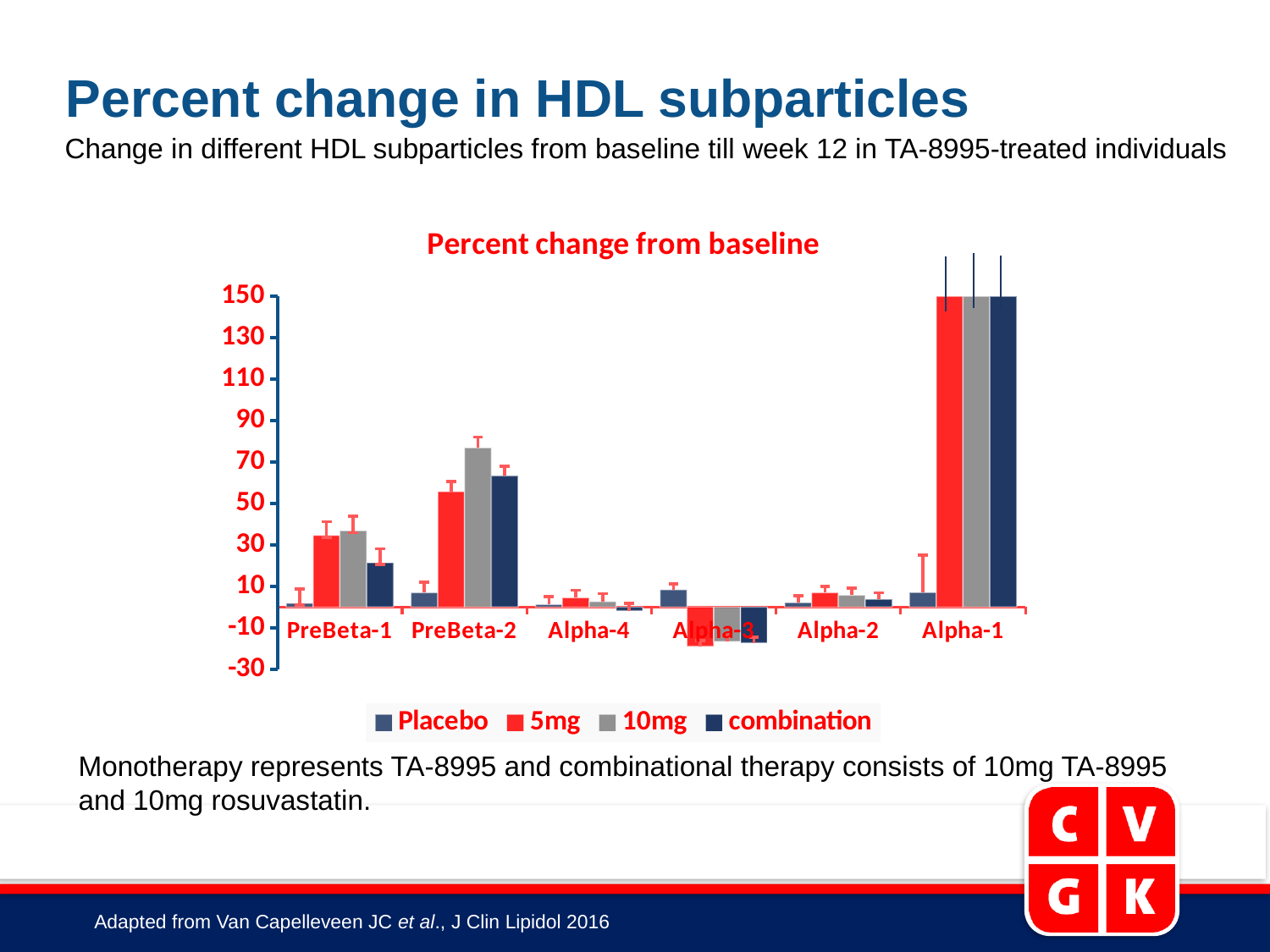
For PreBeta-2, which series has the highest percent change? 10mg For PreBeta-2, which is larger: the 10mg value or the combination value? 10mg Is the value for 5mg at Alpha-3 greater or less than -10? less For PreBeta-1, which is larger: the 5mg value or the combination value? 5mg What kind of chart is shown on the slide? bar chart Which series is shown in red in the legend? 5mg What is the title of the chart? Percent change from baseline Is the value for 5mg at PreBeta-1 greater or less than 30? greater How many HDL subparticle categories are shown on the x axis? 6 Is the value for combination at PreBeta-1 greater or less than 30? less How many series does the legend list? 4